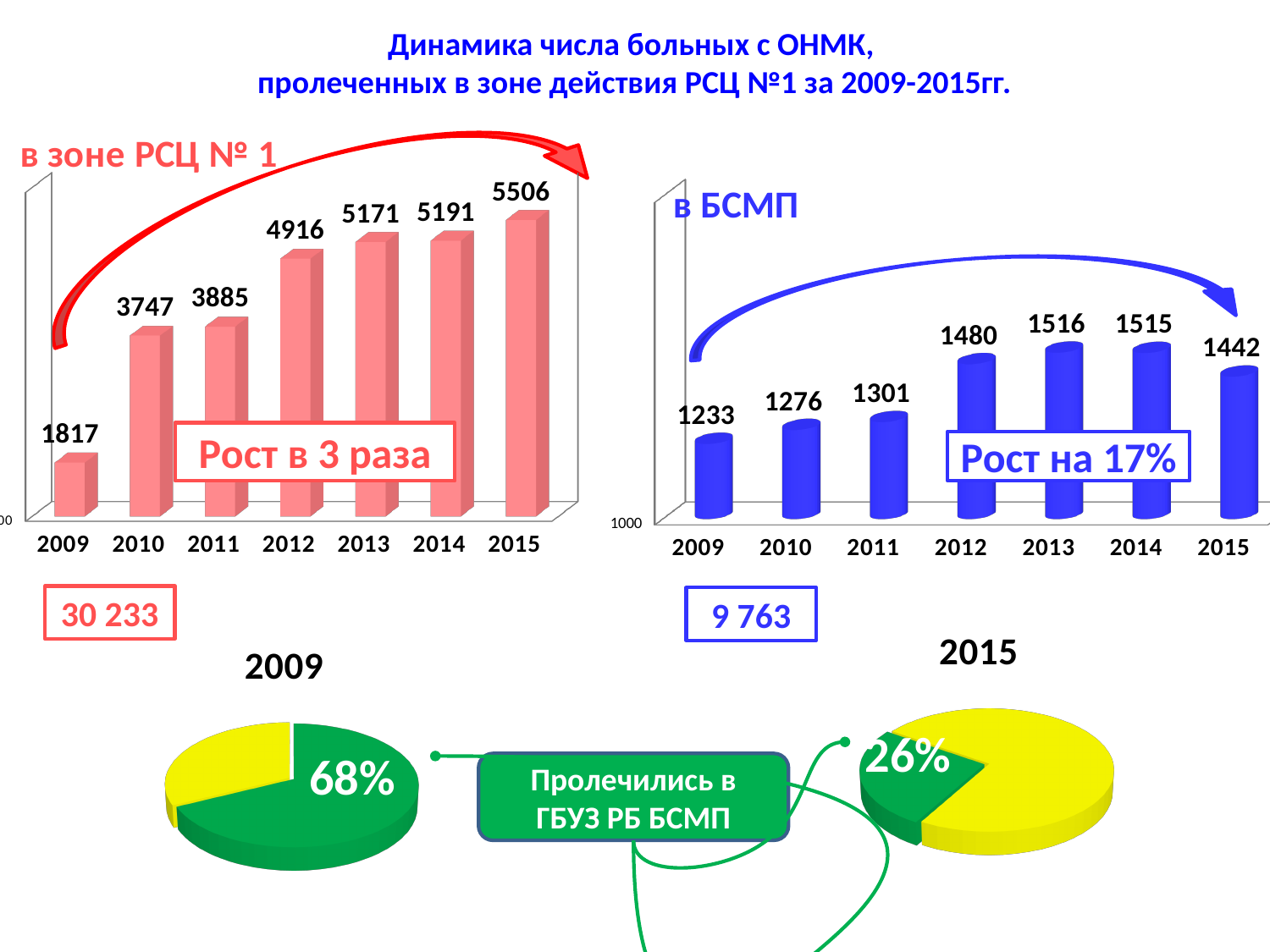
In the bar chart titled "в зоне РСЦ № 1", what is the difference between the values for 2015 and 2009? 3689 How many years are shown on the x axis of the bar chart titled "в зоне РСЦ № 1"? 7 In the bar chart titled "в зоне РСЦ № 1", what is the value for 2012? 4916 In the bar chart titled "в БСМП", which year has the lowest value? 2009 In the bar chart titled "в зоне РСЦ № 1", which year has the highest value? 2015 In the pie chart labelled 2015 at the bottom right, what share does the green slice have? 26% In the pie chart labelled 2009 at the bottom left, what share does the green slice have? 68% In the bar chart titled "в БСМП", what is the value for 2015? 1442 In the bar chart titled "в БСМП", which is larger: the value for 2013 or the value for 2015? 2013 In the bar chart titled "в БСМП", what is the difference between the values for 2012 and 2011? 179 In the bar chart titled "в зоне РСЦ № 1", do the values rise or fall from 2009 to 2015? rise What kind of chart is the chart titled "в БСМП"? bar chart